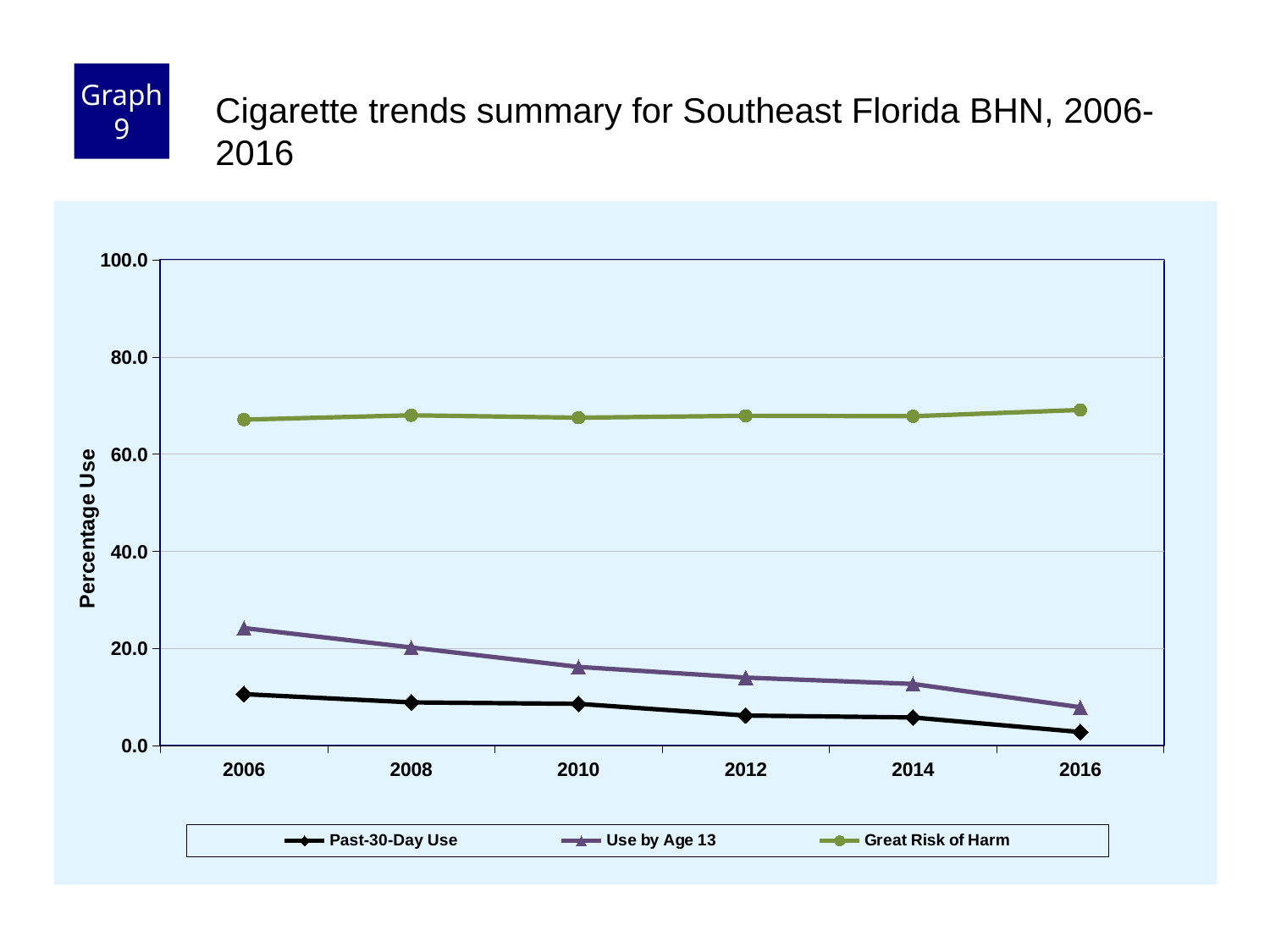
Which series has the highest values across all years? Great Risk of Harm What is the label of the y axis? Percentage Use Is the value for Use by Age 13 in 2006 greater or less than 20.0? greater Is the value for Great Risk of Harm in 2016 greater or less than 60.0? greater What kind of chart is shown on the slide? line chart Is the value for Use by Age 13 in 2016 greater or less than 20.0? less Does the Use by Age 13 series rise or fall from 2006 to 2016? fall In 2010, which is larger: Use by Age 13 or Past-30-Day Use? Use by Age 13 How many years are shown on the x axis? 6 Does the Past-30-Day Use series rise or fall from 2006 to 2016? fall Which series has the lowest values across all years? Past-30-Day Use How many series does the legend list? 3